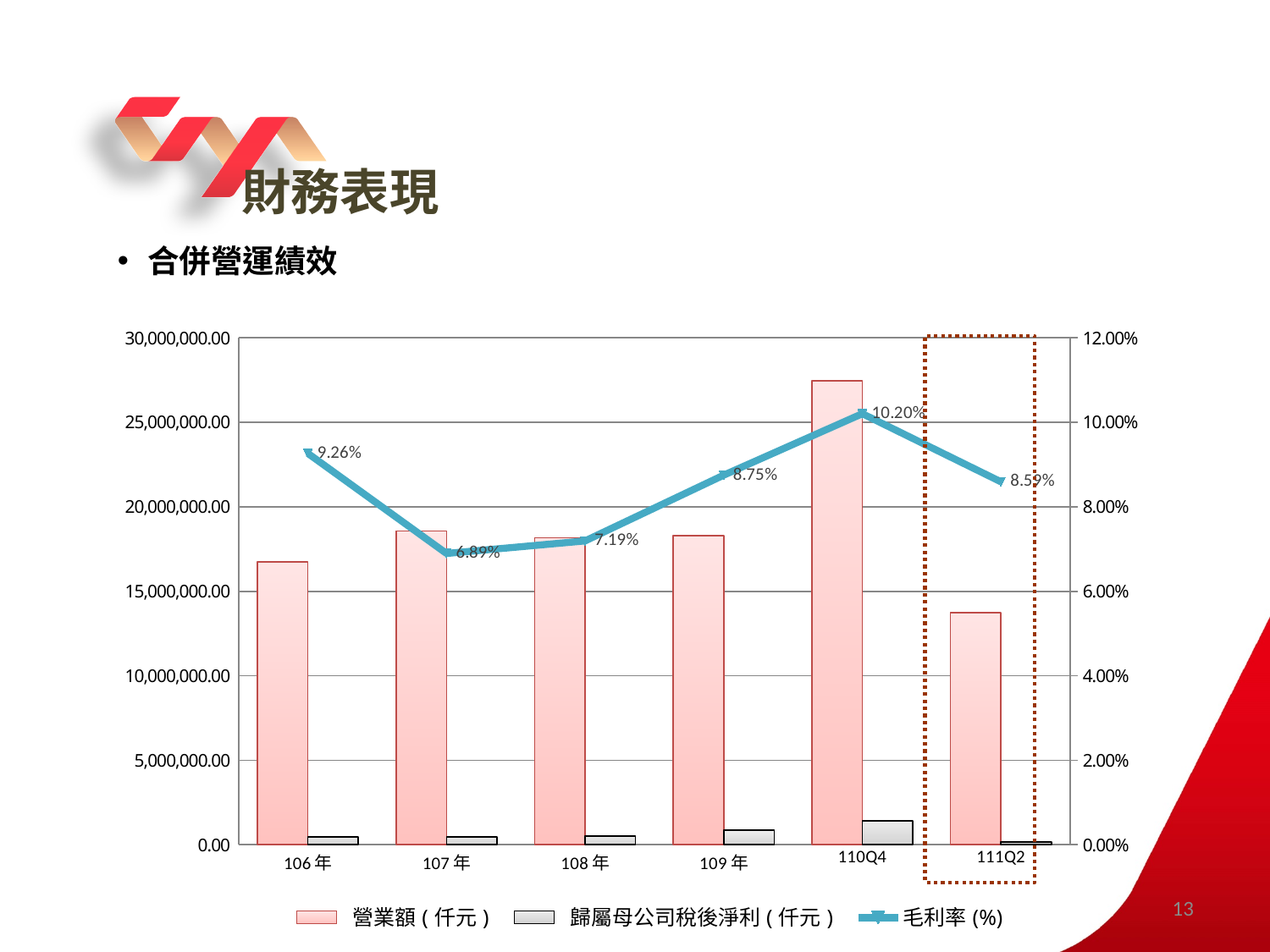
How many categories are shown on the x axis of the chart? 6 Which category has the highest 毛利率 (%)? 110Q4 Is the 營業額 ( 仟元 ) value for 111Q2 greater or less than 15,000,000.00? less What is the 毛利率 (%) value for 110Q4? 10.20% Does the 毛利率 (%) line rise or fall from 107 年 to 110Q4? rise Which category has the highest 營業額 ( 仟元 ) bar? 110Q4 Which has a higher 毛利率 (%), 108 年 or 109 年? 109 年 How many series does the chart legend list? 3 What is the 毛利率 (%) value for 106 年? 9.26% Is the 營業額 ( 仟元 ) value for 110Q4 greater or less than 25,000,000.00? greater What is the difference in 毛利率 (%) between 110Q4 and 111Q2? 1.61% Which category has the lowest 毛利率 (%)? 107 年